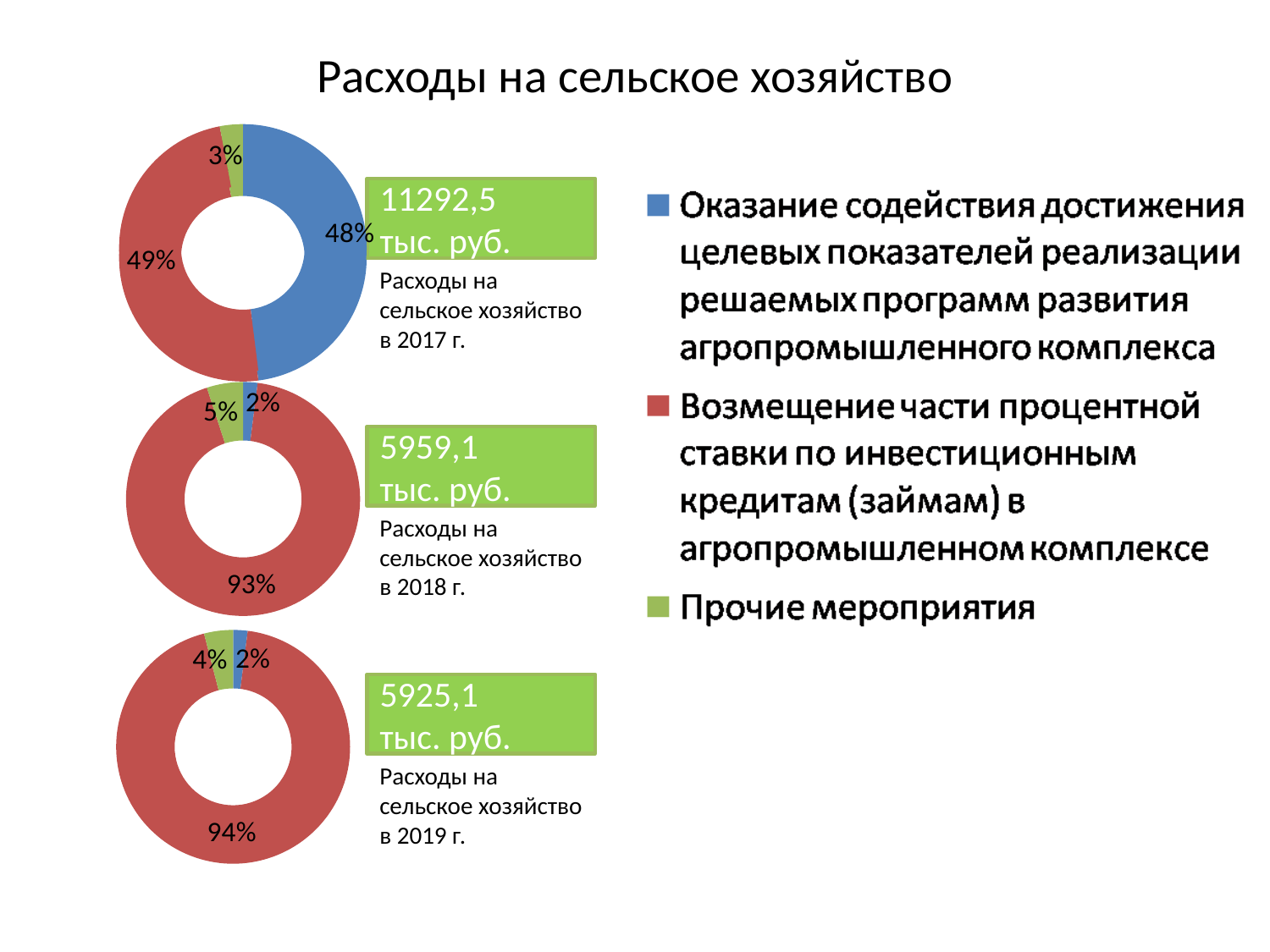
What kind of chart is used to show the agricultural expenditure breakdown for each year? Doughnut (pie) chart In the 2017 chart (Расходы на сельское хозяйство в 2017 г.), what share is shown for Возмещение части процентной ставки по инвестиционным кредитам (займам) в агропромышленном комплексе? 49% In the 2019 chart, which category has the smallest share? Оказание содействия достижения целевых показателей реализации решаемых программ развития агропромышленного комплекса In the 2017 chart, what share is shown for Прочие мероприятия? 3% In the 2018 chart, which category has the largest share? Возмещение части процентной ставки по инвестиционным кредитам (займам) в агропромышленном комплексе How many categories does the legend list for the charts? 3 In the 2018 chart (Расходы на сельское хозяйство в 2018 г.), what share is shown for Возмещение части процентной ставки по инвестиционным кредитам (займам) в агропромышленном комплексе? 93% In the 2017 chart, what is the difference in percentage points between the share for Возмещение части процентной ставки and the share for Прочие мероприятия? 46 percentage points